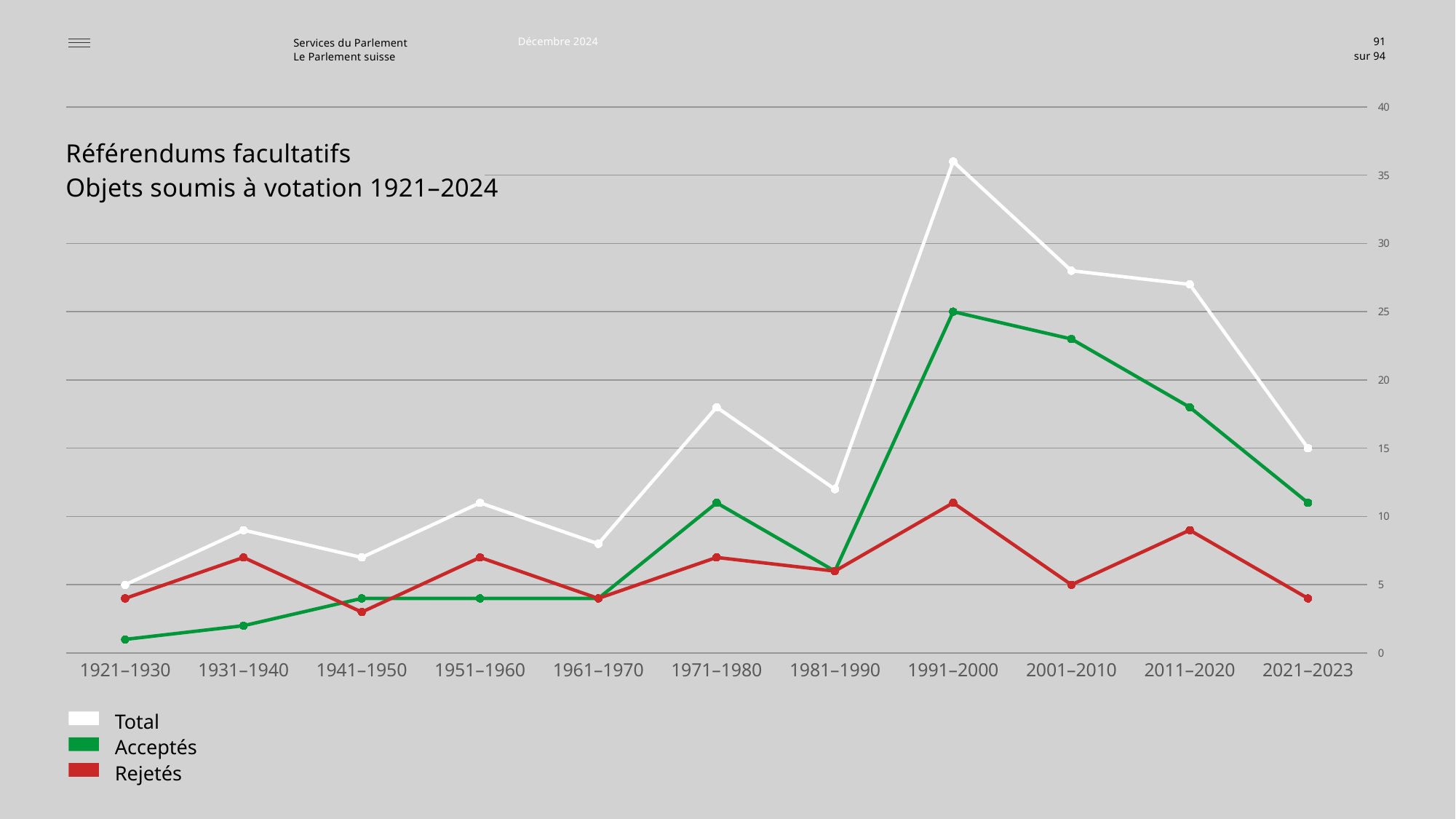
What kind of chart is shown on the slide? line chart In 2001–2010, which is larger, Acceptés or Rejetés? Acceptés What is the value of Total for 1921–1930? 5 Is the value of Total for 1991–2000 greater or less than 35? greater In which period is the Acceptés series lowest? 1921–1930 What is the value of Total for 2021–2023? 15 How many series does the legend list? 3 Is the value of Acceptés for 2001–2010 greater or less than 20? greater Does the Total series rise or fall from 1991–2000 to 2021–2023? fall How many periods are shown along the x axis? 11 What is the value of Acceptés for 1991–2000? 25 In which period is the Total series highest? 1991–2000